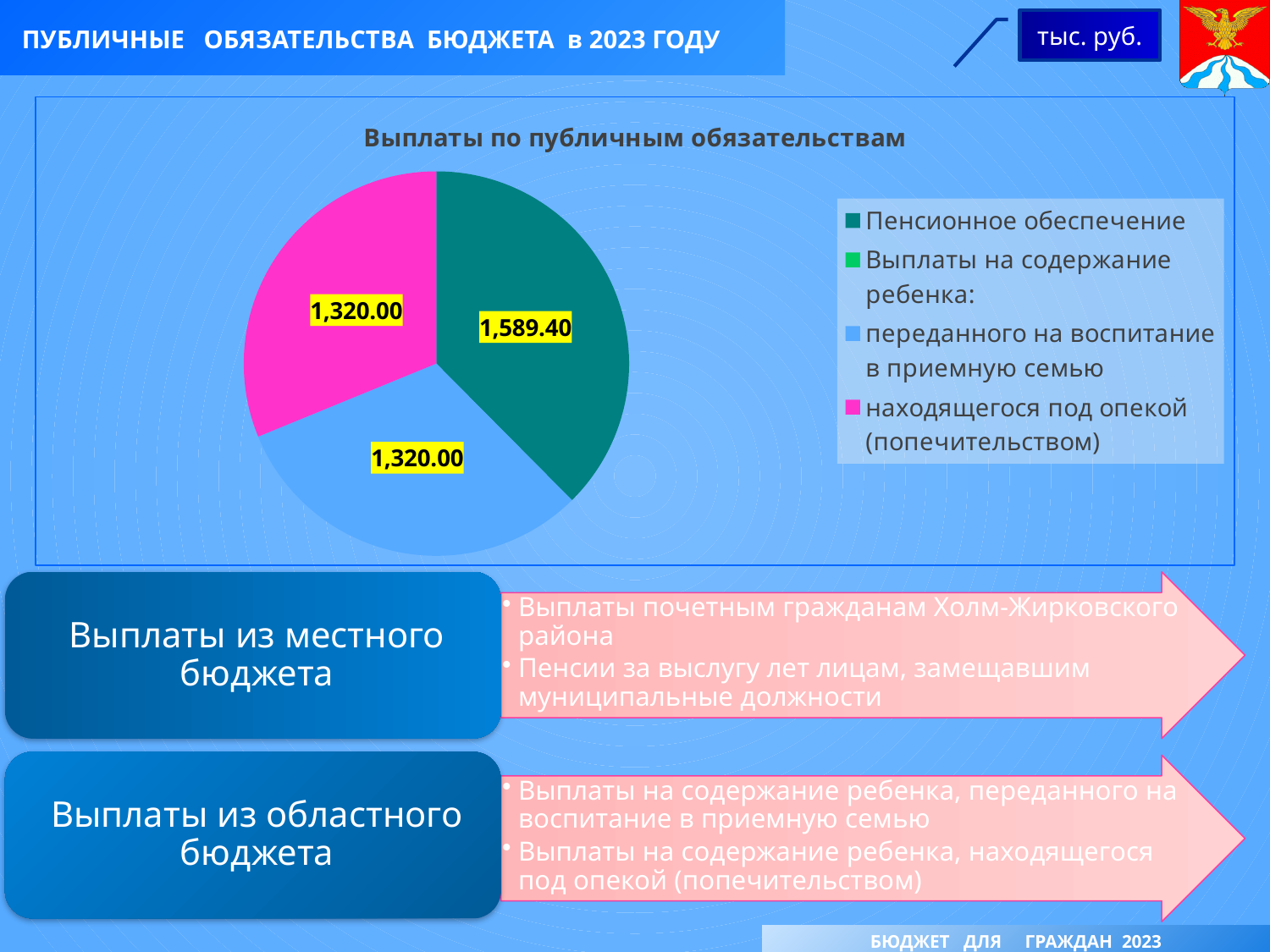
How many entries does the chart legend list? 4 What is the value for the slice 'находящегося под опекой (попечительством)'? 1,320.00 What is the value for Пенсионное обеспечение in the pie chart? 1,589.40 Which category has the largest slice in the pie chart? Пенсионное обеспечение What is the value for the slice 'переданного на воспитание в приемную семью'? 1,320.00 In what units are the chart values given, according to the box at the top of the slide? тыс. руб. What type of chart is shown on the slide? pie chart What is the title of the chart? Выплаты по публичным обязательствам How many slices are visible in the pie chart? 3 What is the total of the three labelled slices in the pie chart? 4,229.40 Which is larger: the value for Пенсионное обеспечение or the value for 'переданного на воспитание в приемную семью'? Пенсионное обеспечение What is the difference between the value for Пенсионное обеспечение and the value for 'находящегося под опекой (попечительством)'? 269.40